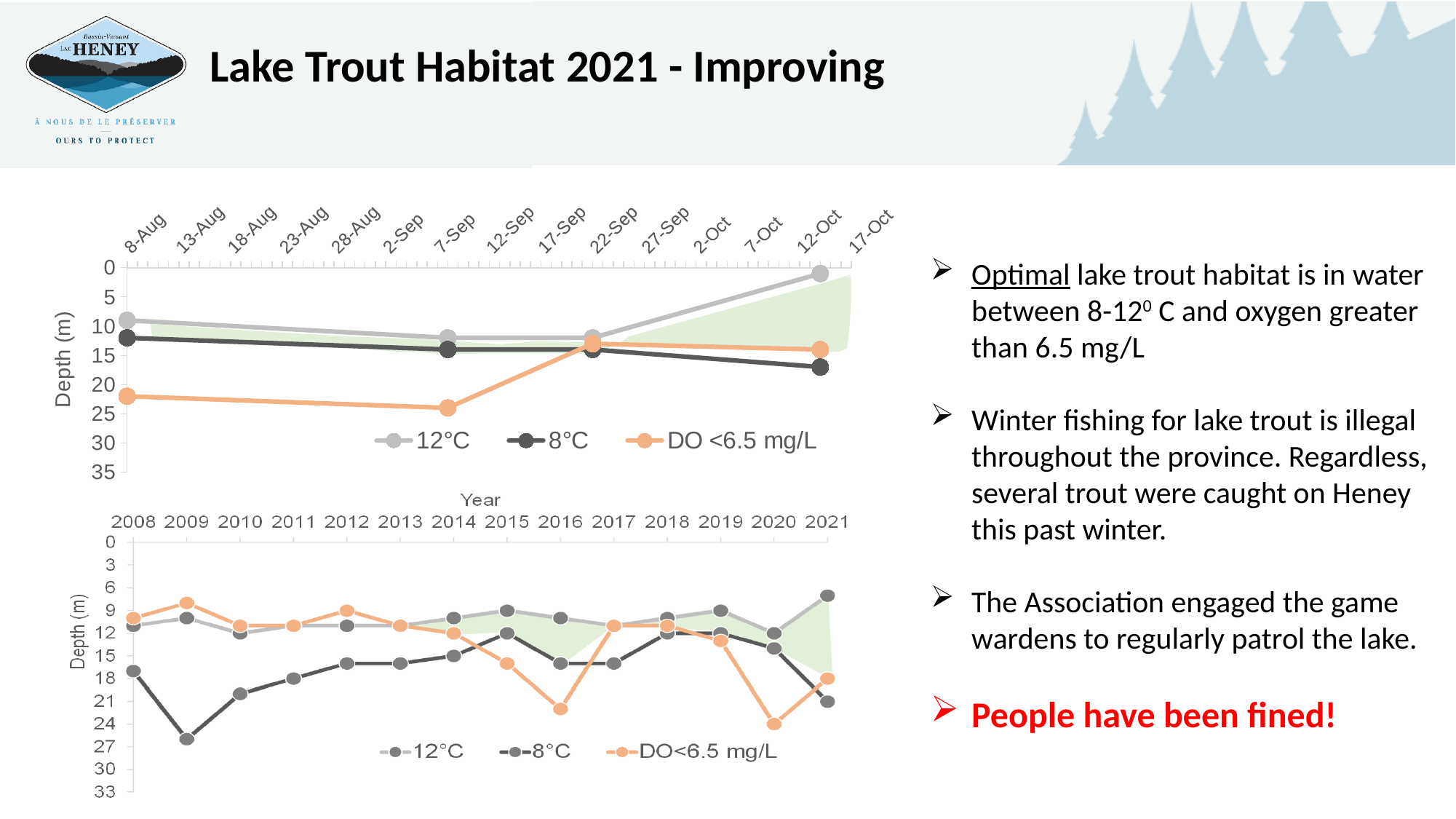
In the bottom chart, which year has the largest depth value for the 8°C series? 2009 In the bottom chart, which is larger in 2008: the depth value for 8°C or for 12°C? 8°C What is the x-axis title of the bottom chart? Year In the top chart, do the depth values for the 8°C series rise or fall from 8-Aug to 12-Oct? rise In the top chart, is the depth value for DO <6.5 mg/L at 8-Aug greater or less than 20? greater In the bottom chart (by Year), how many years are shown on the x axis? 14 What kind of chart is the top chart (dates from 8-Aug to 17-Oct)? line chart In the top chart, is the depth value for 12°C at 12-Oct greater or less than 5? less In the top chart, how many dates have plotted data points? 4 How many series does the legend of the top chart list? 3 In the bottom chart, is the depth value for 8°C in 2009 greater or less than 24? greater In the top chart, which series has the largest depth value at 8-Aug? DO <6.5 mg/L